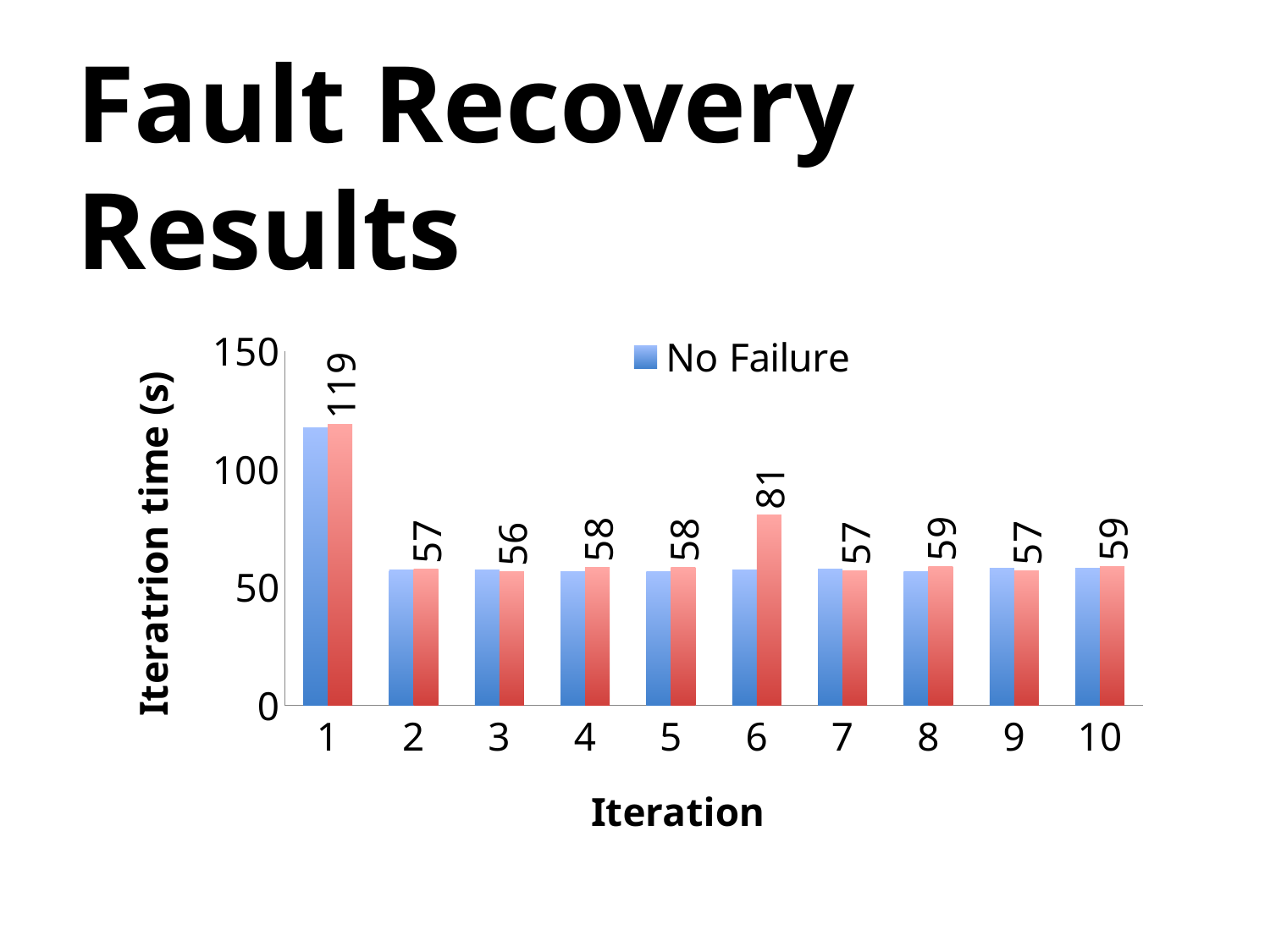
Which iteration has the highest labelled value? 1 What kind of chart is shown on the slide? bar chart What is the difference between the labelled values for iteration 1 and iteration 6? 38 Is the value of the blue bar for iteration 1 greater or less than 100? greater Which has the larger labelled value, iteration 6 or iteration 7? iteration 6 Which iteration has the lowest labelled value? 3 What is the data label shown for iteration 1? 119 What is the data label shown for iteration 3? 56 What is the title of the x axis? Iteration How many iterations are shown on the x axis? 10 What is the data label shown for iteration 6? 81 How many series does the legend list? 1